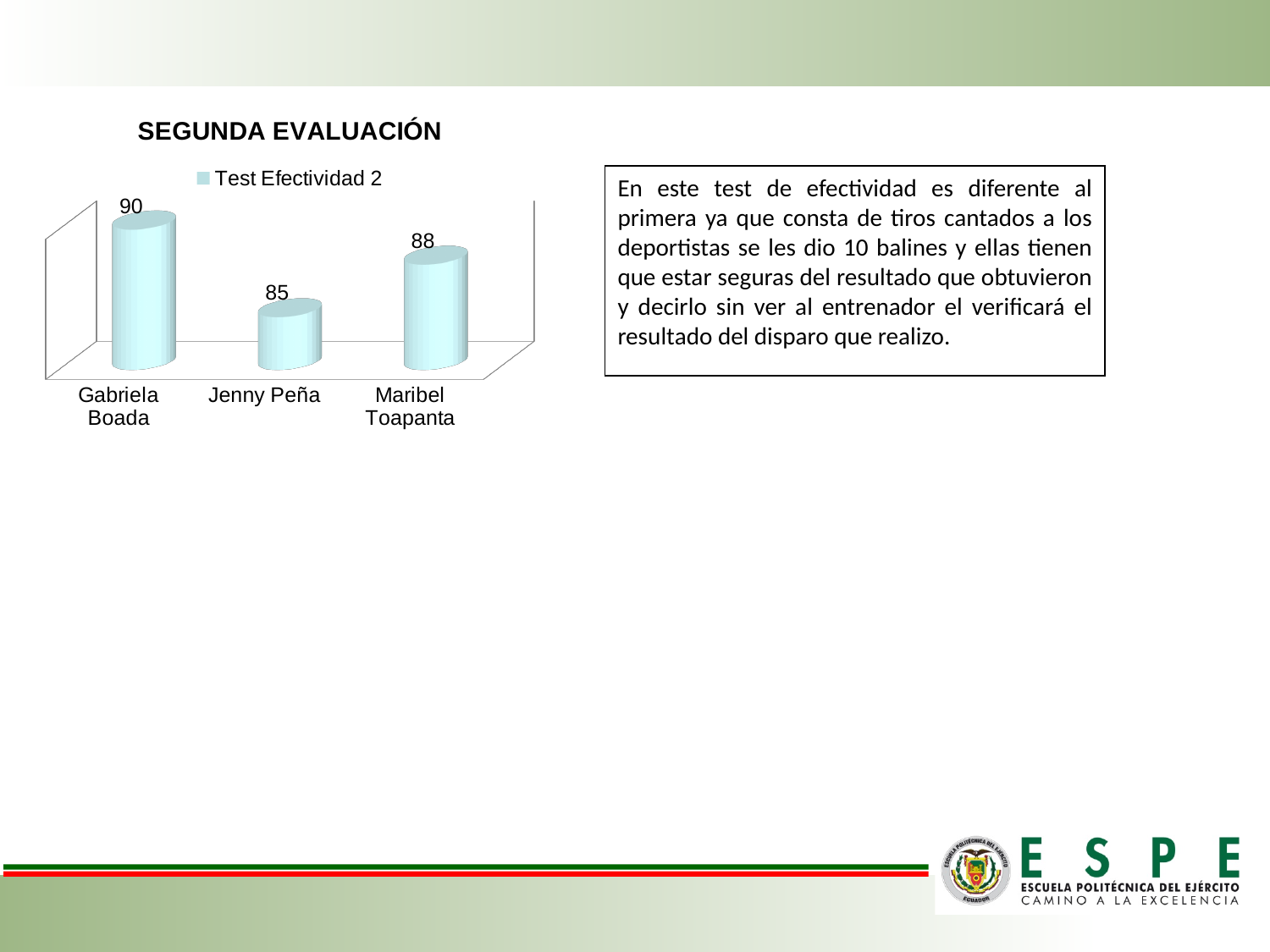
Which category has the highest value? Gabriela Boada What is the value for Maribel Toapanta? 88 What is the difference between the values for Gabriela Boada and Jenny Peña? 5 How many series does the legend list? 1 Which is larger, the value for Maribel Toapanta or the value for Jenny Peña? Maribel Toapanta What is the value for Jenny Peña? 85 Which category has the lowest value? Jenny Peña What is the name of the series shown in the legend? Test Efectividad 2 What is the difference between the values for Maribel Toapanta and Jenny Peña? 3 What kind of chart is shown on the slide? bar chart How many categories are shown in the chart? 3 What is the value for Gabriela Boada? 90